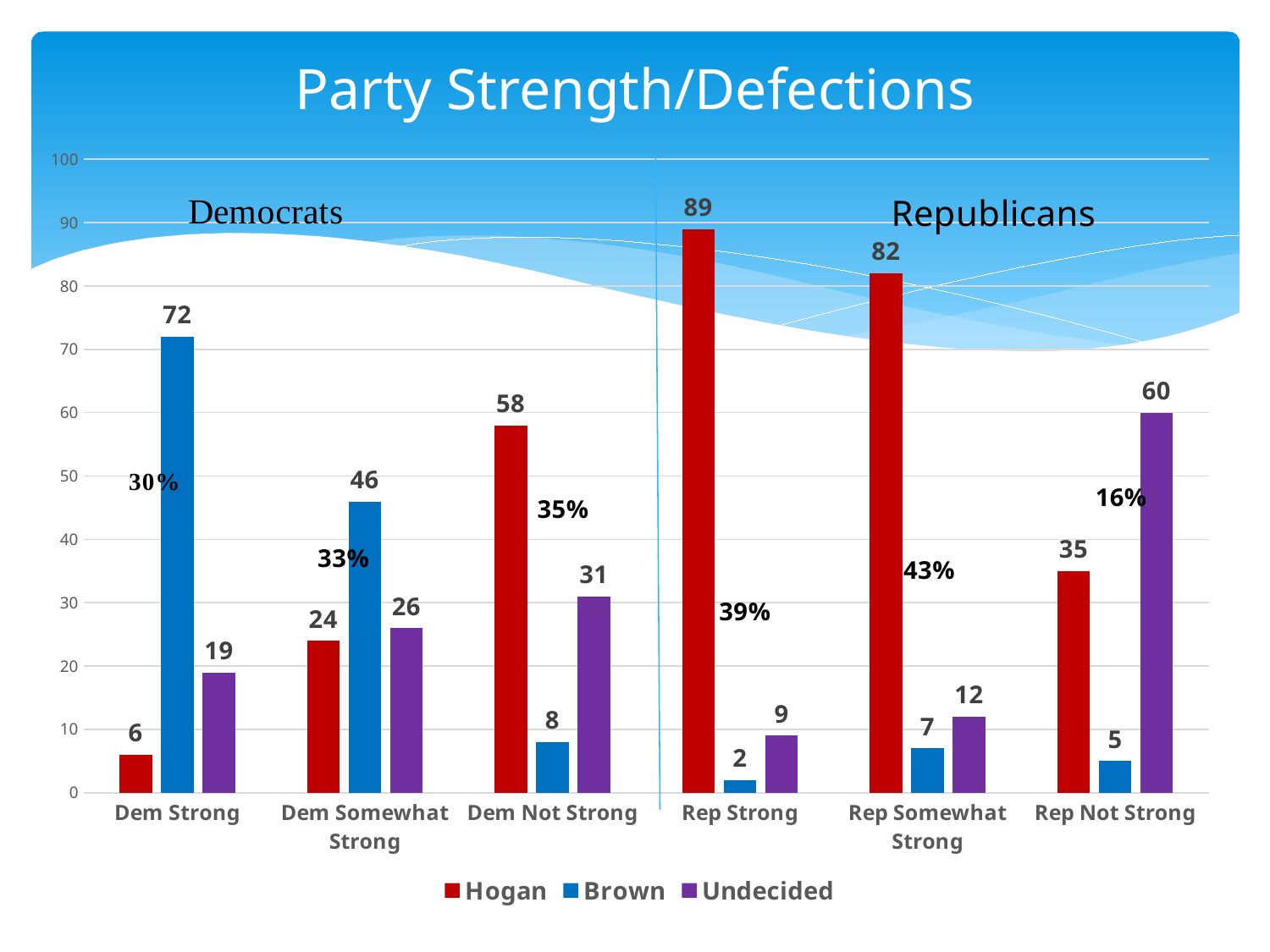
How many series does the legend list? 3 How many categories are shown on the x axis? 6 Which category has the highest Hogan value? Rep Strong Is the value for Hogan in the Rep Somewhat Strong category greater or less than 80? greater What is the value for Undecided in the Rep Not Strong category? 60 What is the value for Brown in the Dem Strong category? 72 What is the title of the chart? Party Strength/Defections Which category has the lowest Brown value? Rep Strong Which is larger in the Dem Somewhat Strong category, Brown or Undecided? Brown What is the value for Hogan in the Rep Strong category? 89 What is the difference between the Hogan and Brown values in the Dem Not Strong category? 50 What kind of chart is shown on the slide? bar chart